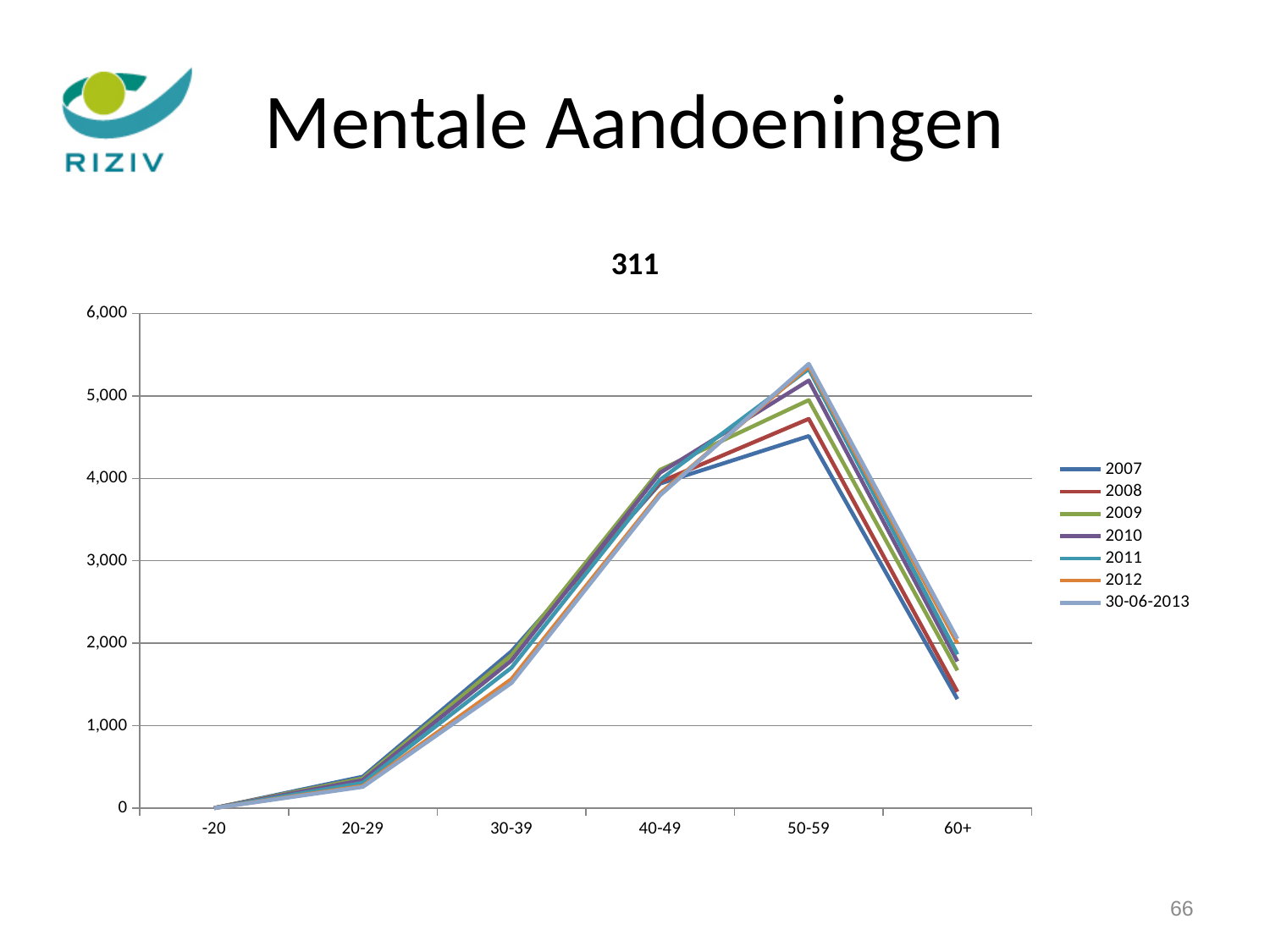
Do the values of the 2007 series rise or fall from 50-59 to 60+? fall For the 30-06-2013 series, which age category has the lowest value? -20 What kind of chart is shown on the slide? line chart How many series does the legend of the chart list? 7 How many age categories are shown on the x axis of the chart? 6 Is the value for 2007 at 60+ greater or less than 2,000? less For the 2007 series, which age category has the highest value? 50-59 Which entry is listed last in the chart's legend? 30-06-2013 At 50-59, which series has the larger value: 2007 or 30-06-2013? 30-06-2013 Is the value for 30-06-2013 at 50-59 greater or less than 5,000? greater Is the value for 2007 at 50-59 greater or less than 4,000? greater What is the title of the chart? 311